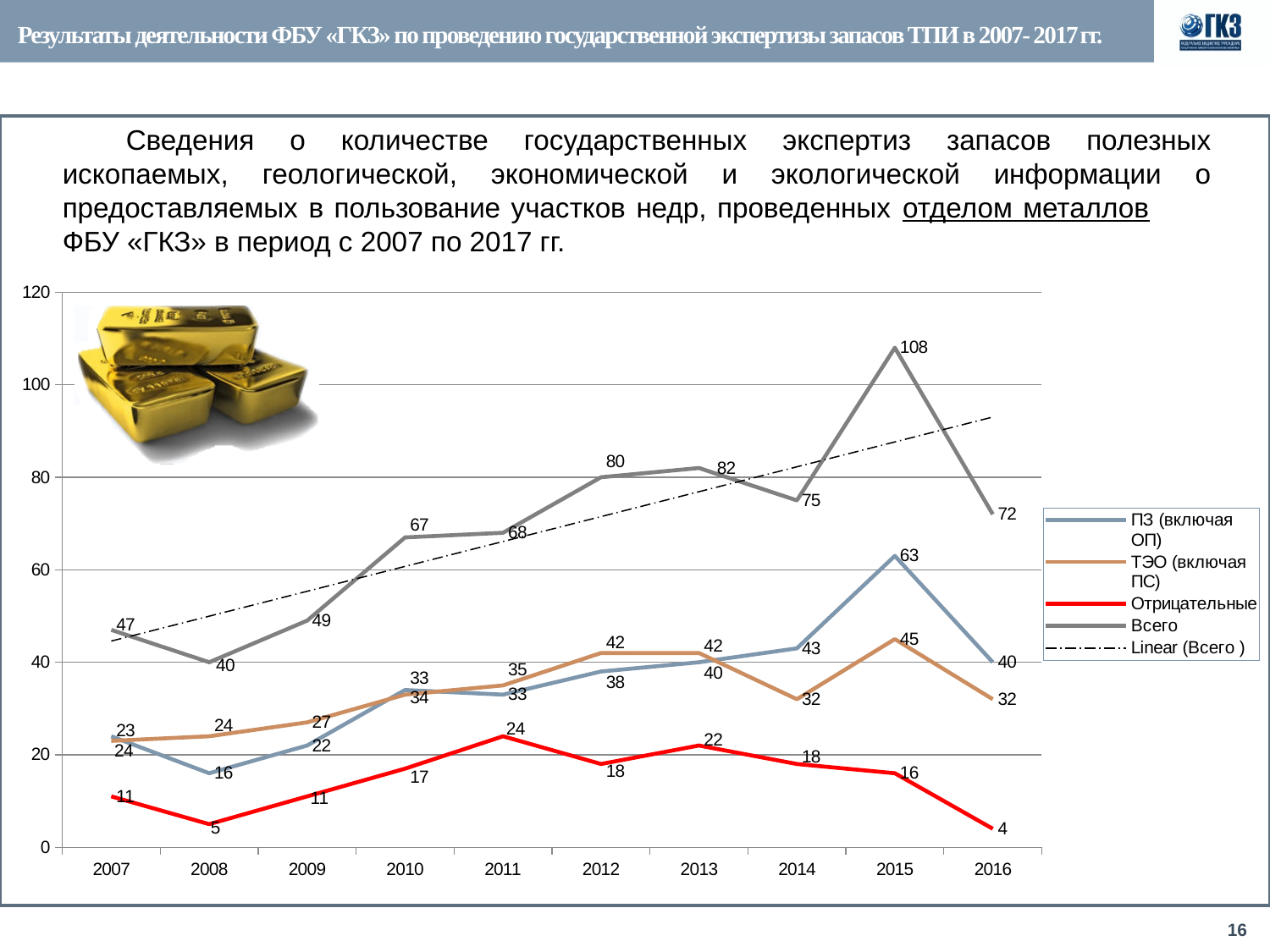
What is the value of the Всего series in 2015? 108 How many series does the legend list? 5 In which year is the Отрицательные series highest? 2011 Does the Отрицательные series rise or fall from 2013 to 2016? fall In 2014, which is larger: ПЗ (включая ОП) or ТЭО (включая ПС)? ПЗ (включая ОП) How many years are shown on the x axis? 10 What is the difference between the Всего values in 2015 and 2016? 36 What kind of chart is shown on the slide? line chart In which year is the Всего series highest? 2015 What is the value of the Отрицательные series in 2016? 4 In which year is the Всего series lowest? 2008 What is the value of the ПЗ (включая ОП) series in 2015? 63